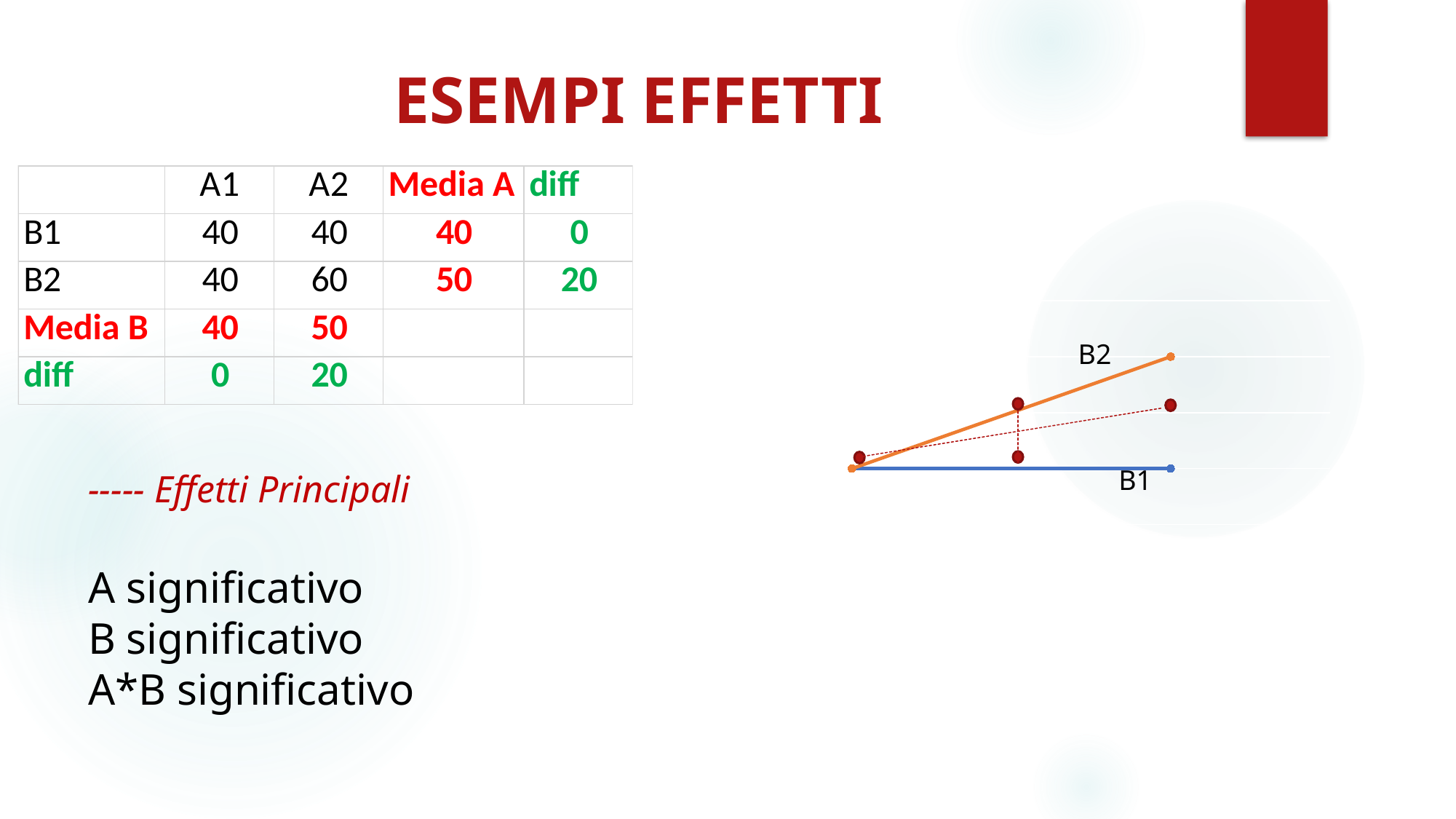
Which line is drawn in blue? B1 How many labelled lines (series) are plotted in the chart? 2 Does the B1 line rise, fall or stay flat from left to right? stays flat What kind of chart is shown on the right of the slide? line chart Does the B2 line rise, fall or stay flat from left to right? rises According to the legend text on the slide, what do the dashed red lines in the chart represent? Effetti Principali At the right end of the chart, which line is higher, B1 or B2? B2 Which line is drawn in orange? B2